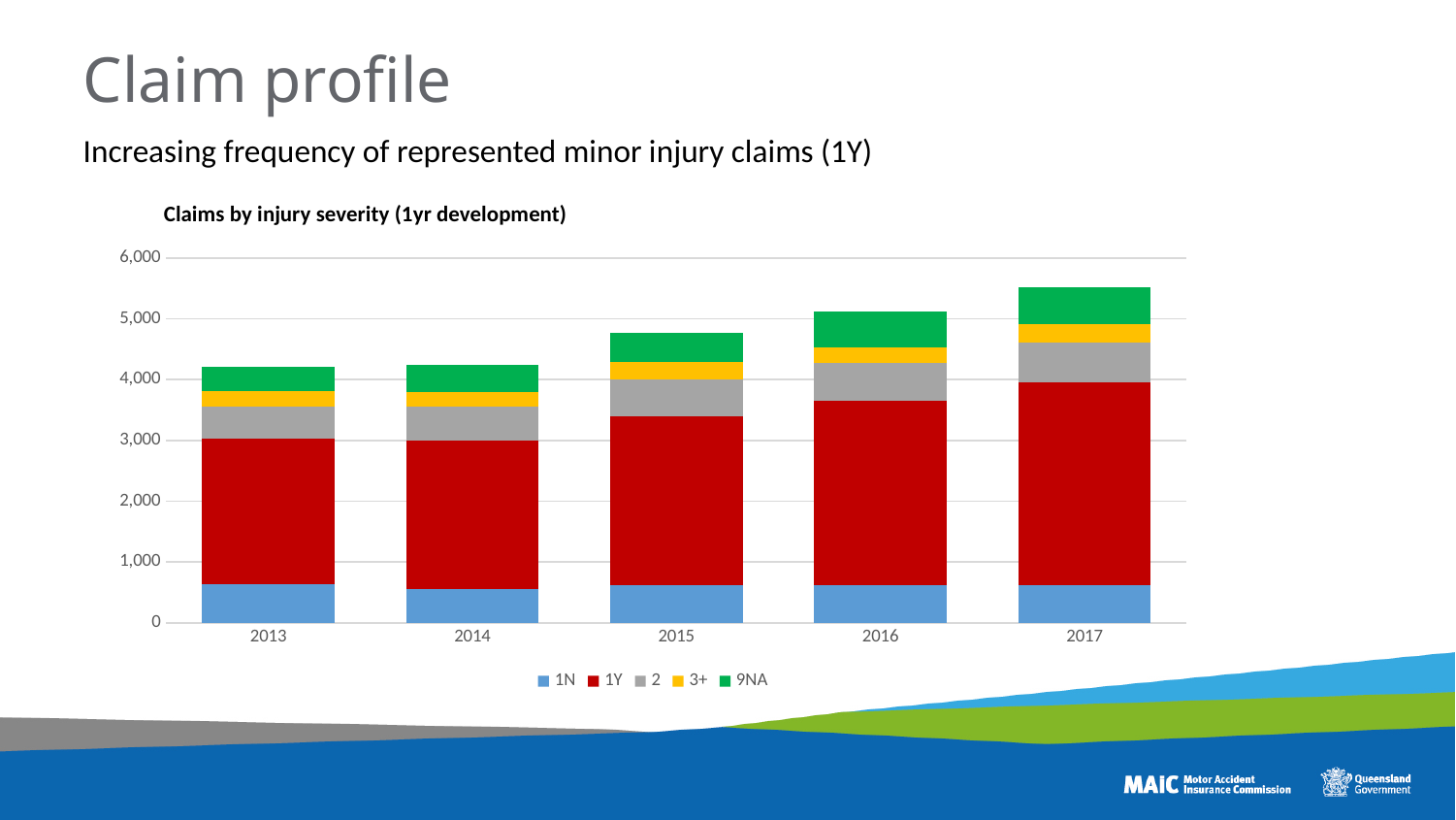
Which year has the larger total number of claims, 2013 or 2017? 2017 Is the total number of claims for 2014 greater or less than 5,000? less Which year has the highest total number of claims? 2017 Do the total claims rise or fall from 2013 to 2017? Rise Is the total number of claims for 2017 greater or less than 5,000? greater Is the total number of claims for 2015 greater or less than 5,000? less How many years are shown on the x axis of the chart? 5 Which series is shown in red in the chart? 1Y How many series does the chart legend list? 5 What is the title of the chart? Claims by injury severity (1yr development) What kind of chart is shown on the slide? Stacked bar chart